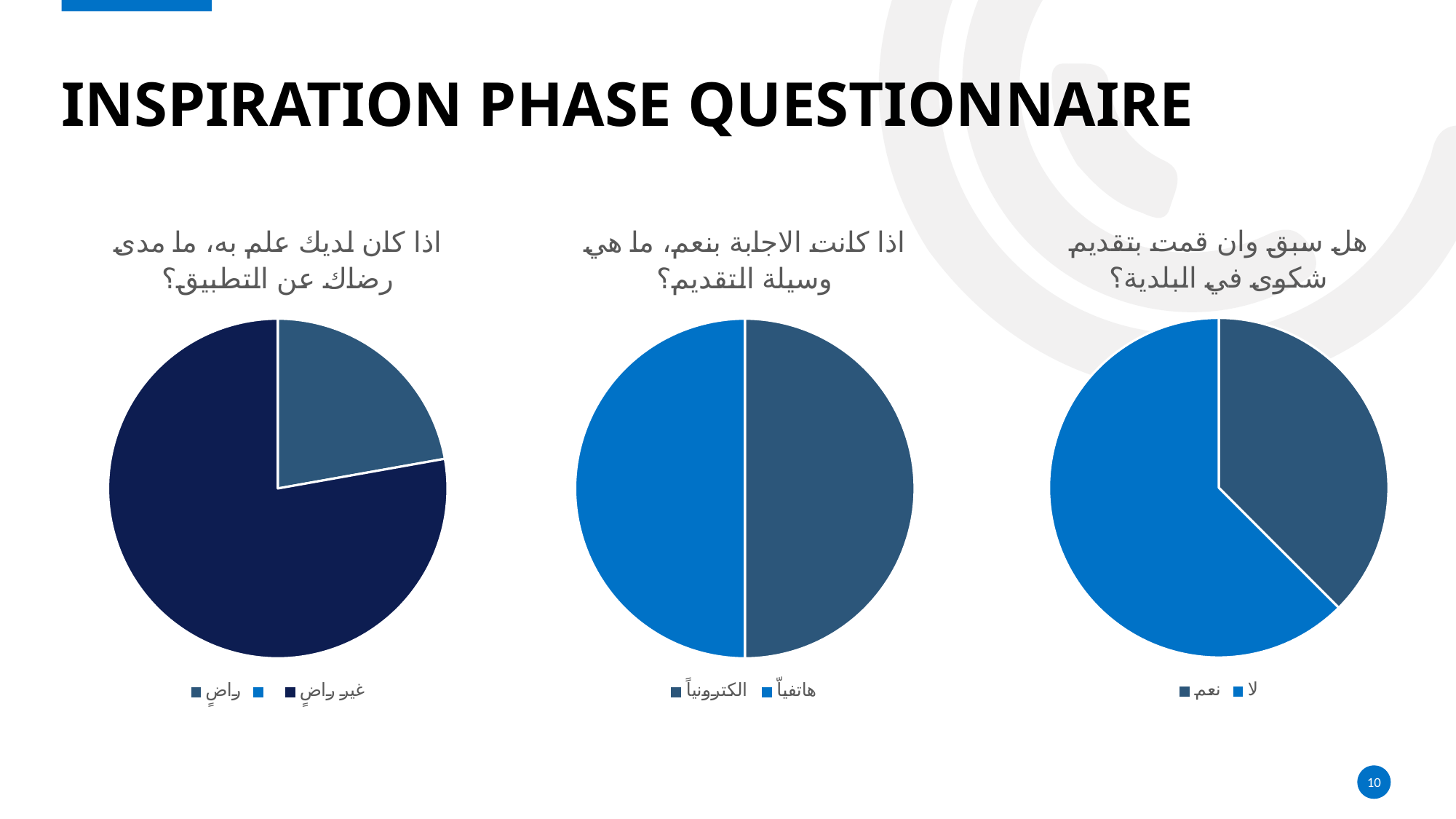
In the right chart (هل سبق وان قمت بتقديم شكوى في البلدية؟), which category has the smaller slice? نعم How many entries does the legend of the right chart list? 2 How many charts are shown on the slide? 3 In the left chart (اذا كان لديك علم به، ما مدى رضاك عن التطبيق؟), which labelled category has the smallest visible slice? راضٍ What are the two legend entries of the middle chart (اذا كانت الاجابة بنعم، ما هي وسيلة التقديم؟)? الكترونياً and هاتفياً In the right chart (هل سبق وان قمت بتقديم شكوى في البلدية؟), which category has the larger slice? لا What kind of chart is the left chart on the slide? Pie chart In the right chart, is the slice for لا larger or smaller than the slice for نعم? Larger How many entries does the legend of the middle chart list? 2 What kind of chart is the middle chart on the slide? Pie chart In the left chart (اذا كان لديك علم به، ما مدى رضاك عن التطبيق؟), which category has the largest slice? غير راضٍ What kind of chart is the right chart on the slide? Pie chart